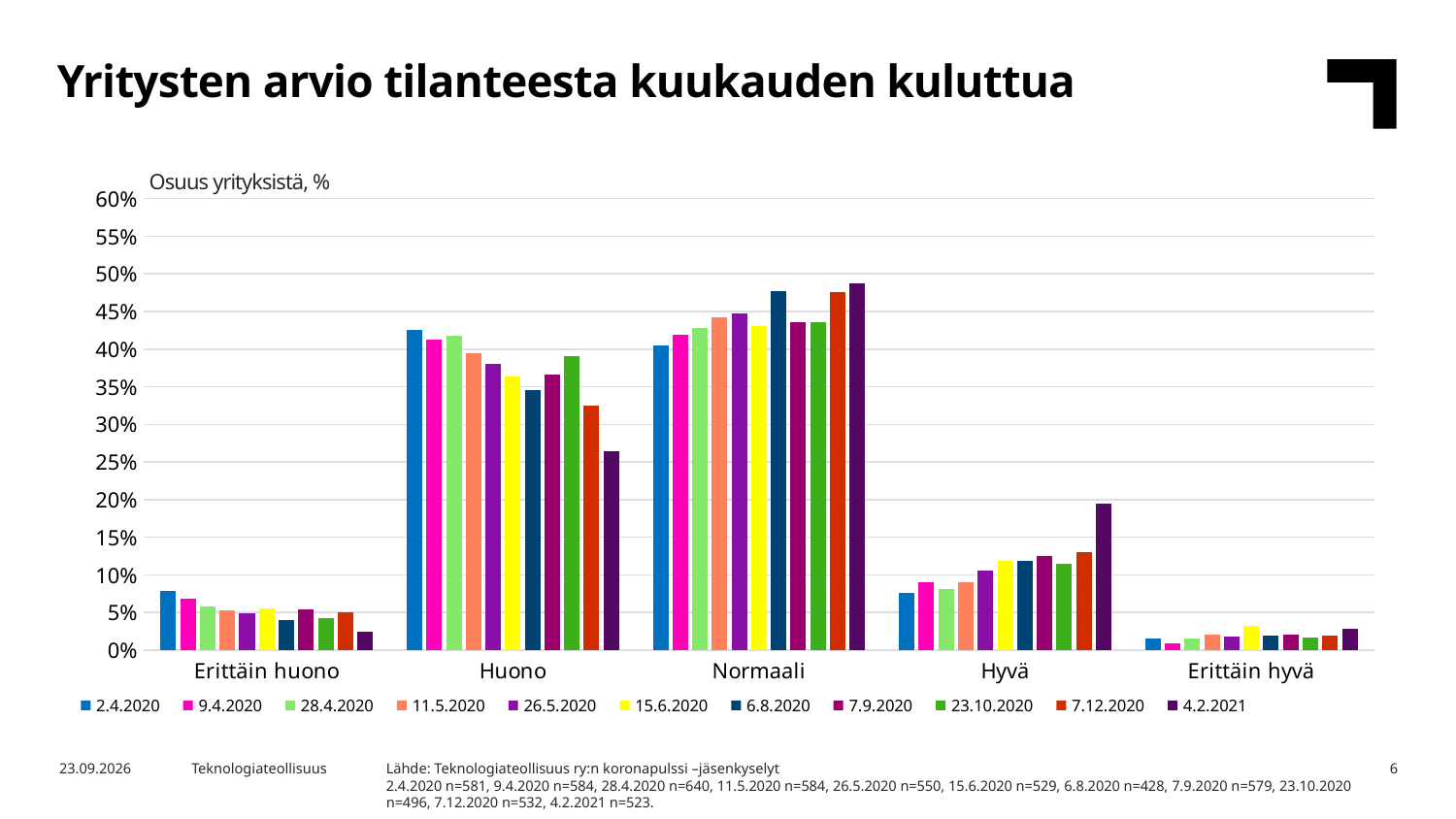
Is the value for Normaali on 4.2.2021 greater or less than 45%? greater Is the value for Hyvä on 4.2.2021 greater or less than 15%? greater For the Huono category, does the value rise or fall from 2.4.2020 to 4.2.2021? fall What kind of chart is shown on the slide? bar chart Is the value for Huono on 4.2.2021 greater or less than 30%? less Which category has the lowest values across all survey dates? Erittäin hyvä In the Normaali category, which is larger: the value for 2.4.2020 or the value for 4.2.2021? 4.2.2021 For the 4.2.2021 series, which category has the highest value? Normaali How many series does the chart's legend list? 11 How many categories are shown on the x axis of the chart? 5